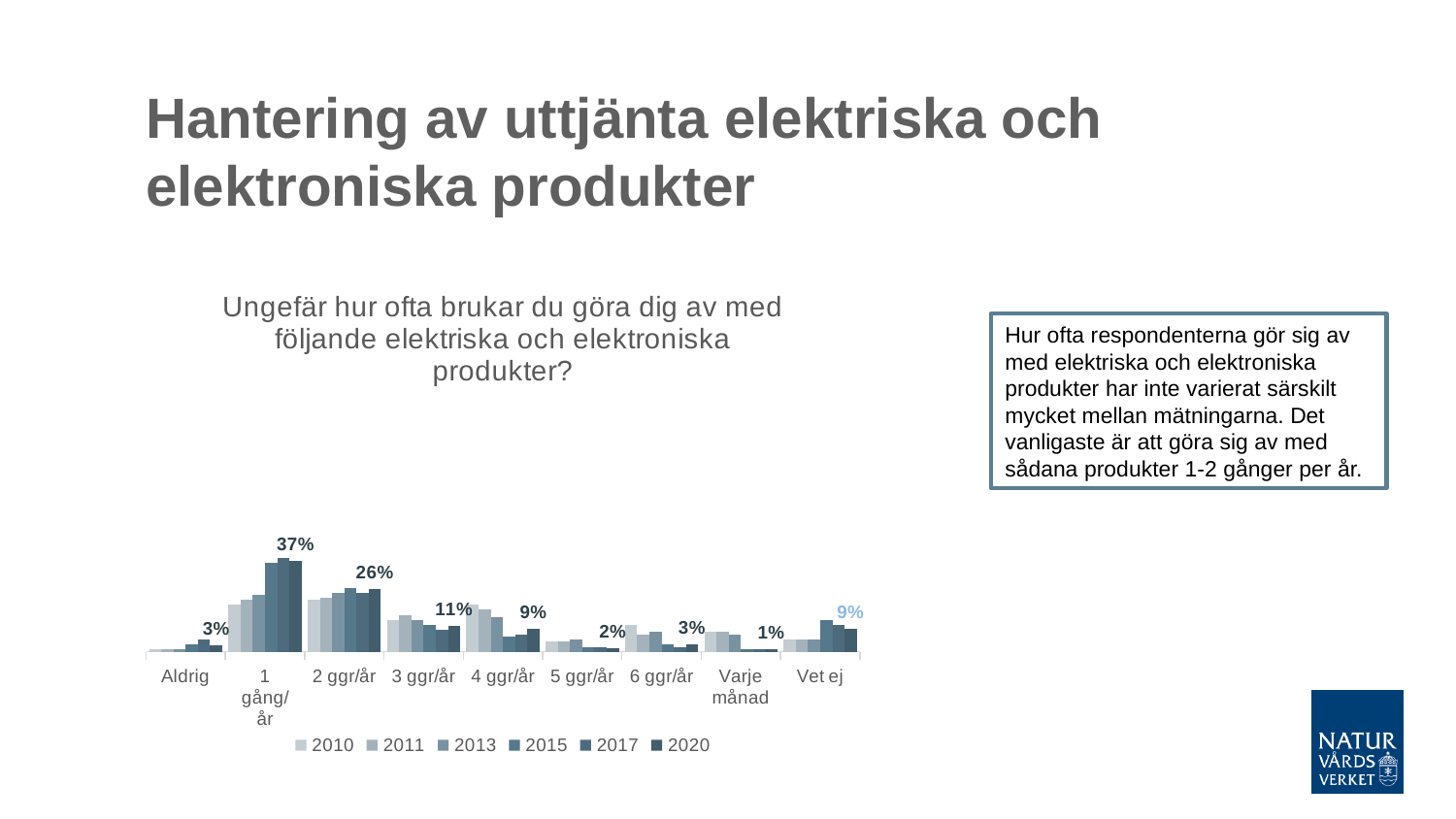
How many series does the chart legend list? 6 How many categories are shown along the x axis of the chart? 9 Which has the larger labelled value, '3 ggr/år' or '4 ggr/år'? 3 ggr/år What is the difference between the labelled values for '1 gång/år' and '2 ggr/år'? 11 percentage points What percentage is labelled for the category 'Varje månad'? 1% Which year is listed first in the chart legend? 2010 Which category has the lowest labelled value in the chart? Varje månad What percentage is labelled for the category '2 ggr/år'? 26% What percentage is labelled for the category '1 gång/år'? 37% What percentage is labelled for the category 'Vet ej'? 9% Which category has the highest labelled value in the chart? 1 gång/år What kind of chart is shown on the slide? bar chart